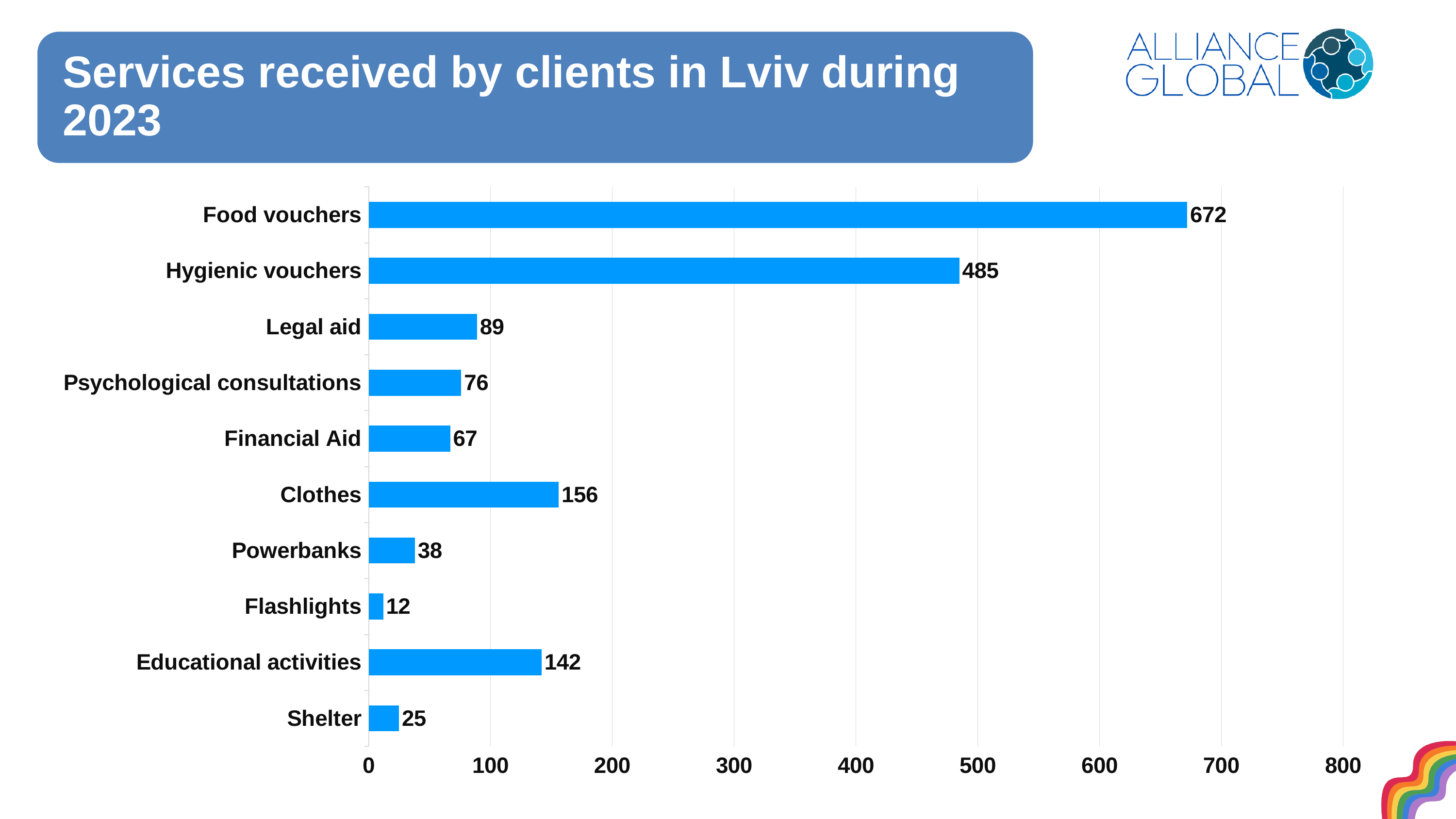
What kind of chart is shown on the slide? Bar chart What is the difference between Food vouchers and Hygienic vouchers? 187 Which category has the highest value? Food vouchers What is the value for Psychological consultations? 76 Which category has the lowest value? Flashlights Which is larger, Legal aid or Financial Aid? Legal aid What is the value for Food vouchers? 672 What is the title of the slide? Services received by clients in Lviv during 2023 How many categories are shown in the chart? 10 What is the difference between Clothes and Educational activities? 14 Which is larger, Powerbanks or Shelter? Powerbanks What is the value for Educational activities? 142